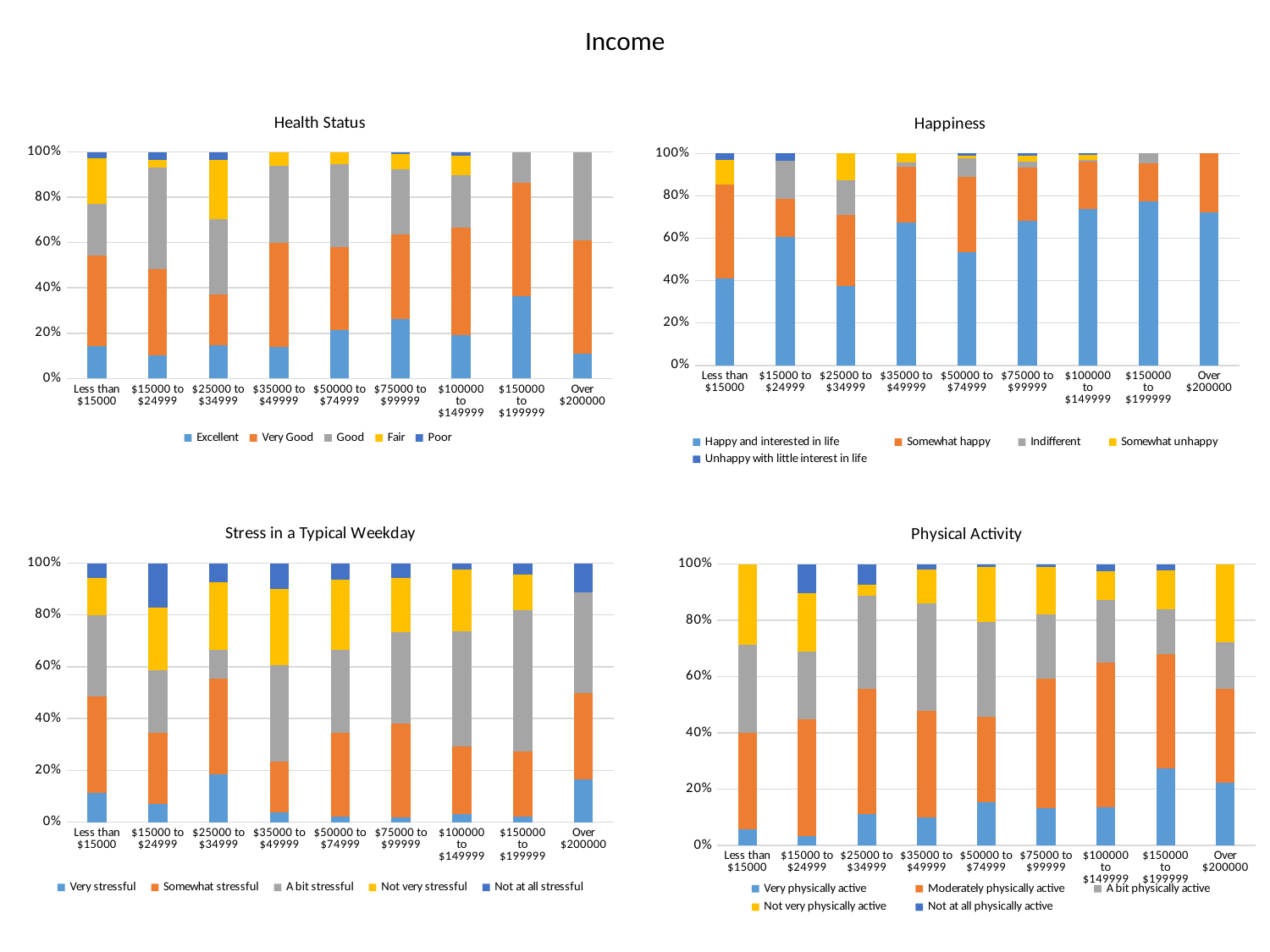
How many charts are on the slide? 4 In the Happiness chart, which income category has the lowest value for Happy and interested in life? $25000 to $34999 In the Health Status chart, what kind of chart is shown? Stacked bar chart In the Physical Activity chart, what colour represents Not very physically active in the legend? Yellow In the Physical Activity chart, is the Very physically active value for $15000 to $24999 greater or less than 20%? less In the Health Status chart, how many series does the legend list? 5 In the Happiness chart, how many series does the legend list? 5 In the Health Status chart, how many income categories are shown on the x axis? 9 In the Health Status chart, which is larger: the Excellent value for $150000 to $199999 or for Less than $15000? $150000 to $199999 In the Health Status chart, is the Excellent value for $150000 to $199999 greater or less than 20%? greater In the Stress in a Typical Weekday chart, which income category has the highest value for Not at all stressful? $15000 to $24999 In the Happiness chart, is the Happy and interested in life value for Less than $15000 greater or less than 60%? less